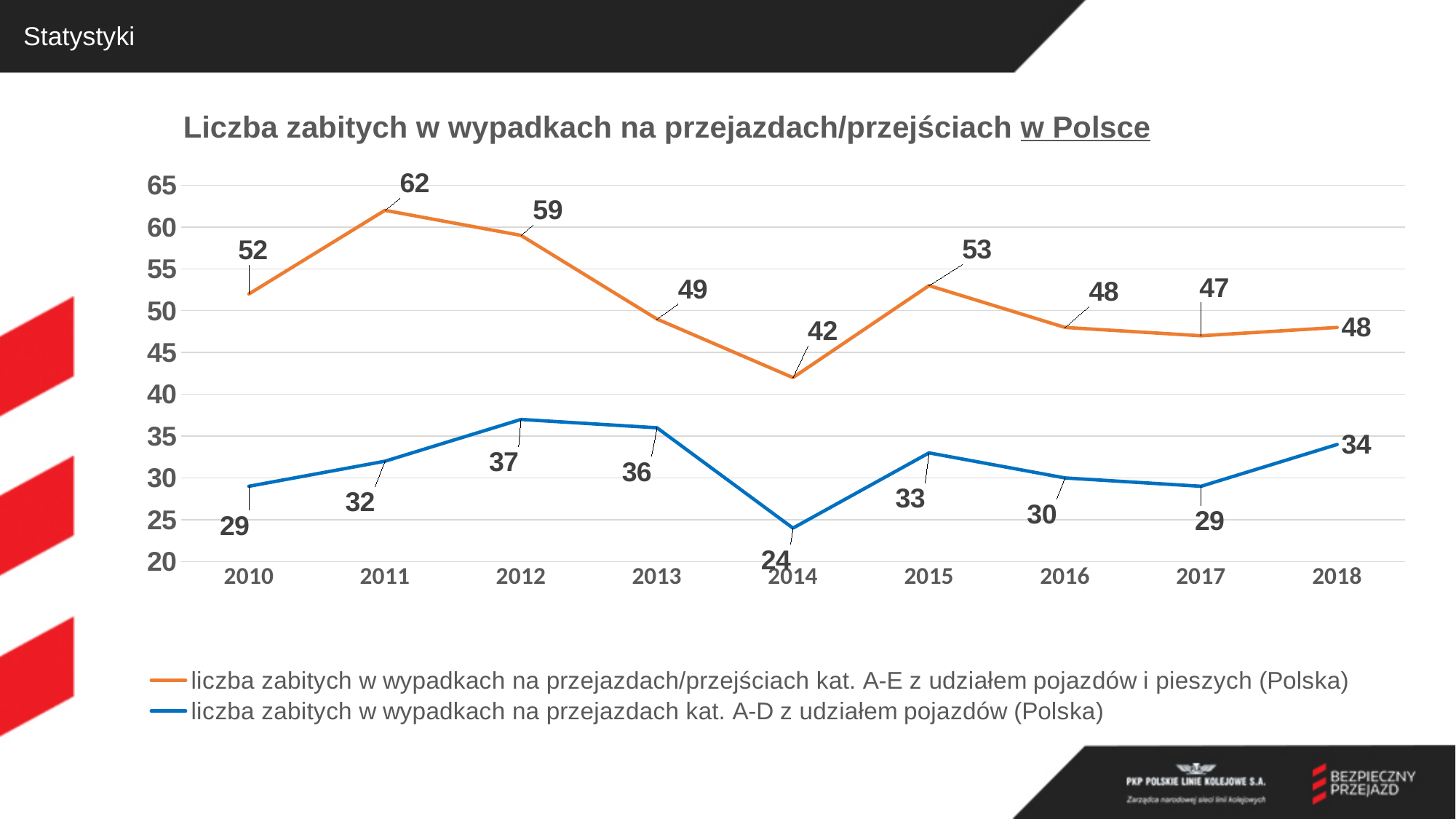
Does the kat. A-E series (orange line) rise or fall from 2011 to 2014? fall In which year is the kat. A-E series (orange line) highest? 2011 What is the value for 2014 in the kat. A-D series (blue line)? 24 What is the difference between the kat. A-D values in 2012 and 2013? 1 Which is larger: the kat. A-E value in 2012 or the kat. A-E value in 2015? 2012 What colour is the line for the kat. A-D series? blue What is the value for 2011 in the kat. A-E series (orange line)? 62 What is the difference between the kat. A-E and kat. A-D values in 2018? 14 How many years are plotted on the x axis? 9 How many series does the legend list? 2 In which year is the kat. A-D series (blue line) lowest? 2014 What type of chart is shown on the slide? line chart